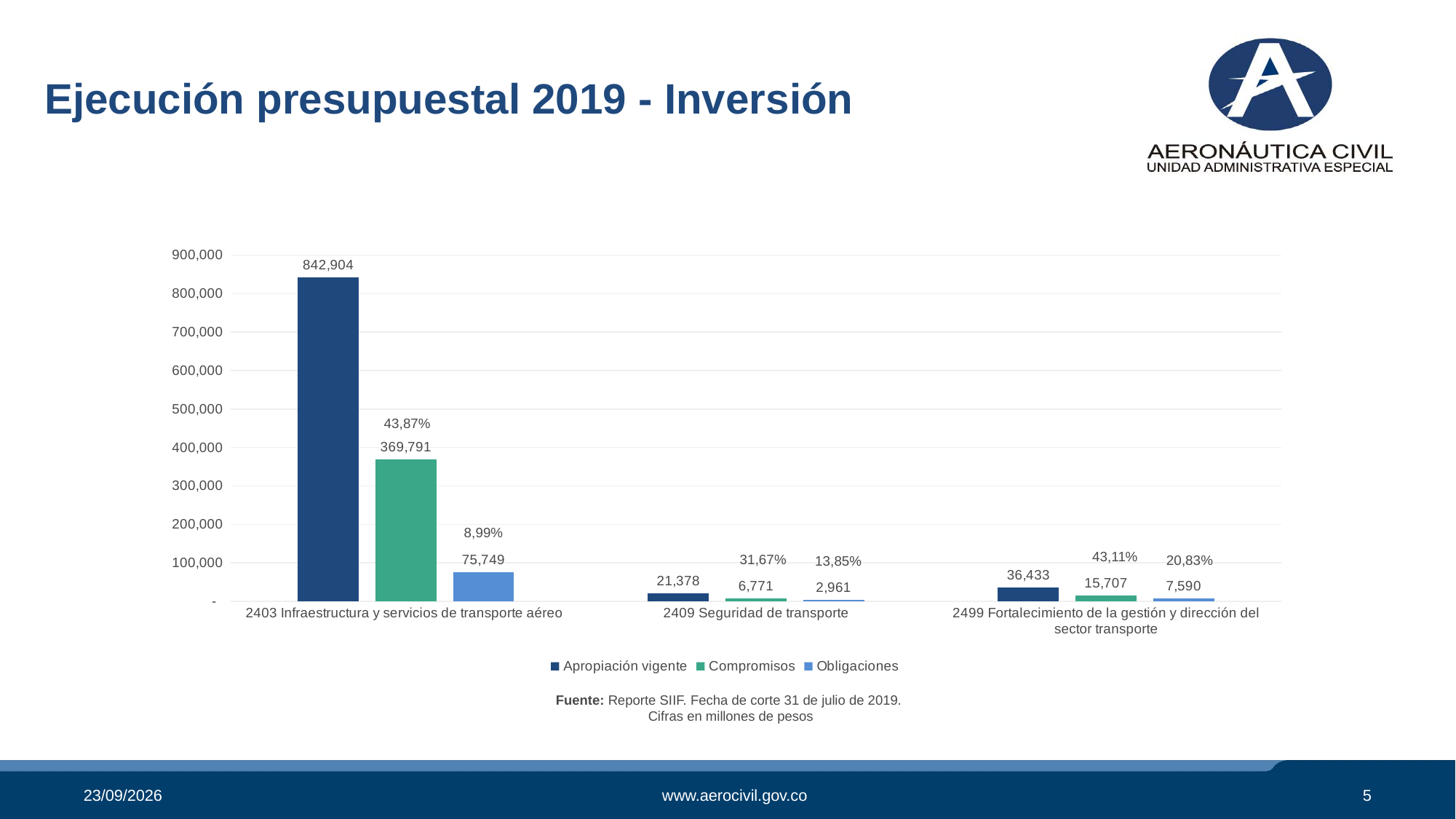
What is the Obligaciones value for 2499 Fortalecimiento de la gestión y dirección del sector transporte? 7,590 Which category has the lowest Obligaciones value? 2409 Seguridad de transporte What is the Apropiación vigente value for 2403 Infraestructura y servicios de transporte aéreo? 842,904 What is the difference between Apropiación vigente and Compromisos for 2403 Infraestructura y servicios de transporte aéreo? 473,113 What is the difference between the Apropiación vigente values for 2499 Fortalecimiento de la gestión y dirección del sector transporte and 2409 Seguridad de transporte? 15,055 What kind of chart is shown on the slide? Bar chart How many categories are shown on the x axis? 3 Which is larger: Compromisos for 2499 Fortalecimiento de la gestión y dirección del sector transporte or Apropiación vigente for 2409 Seguridad de transporte? Apropiación vigente for 2409 Seguridad de transporte What percentage is shown above the Compromisos bar for 2403 Infraestructura y servicios de transporte aéreo? 43,87% What is the Compromisos value for 2409 Seguridad de transporte? 6,771 Which category has the highest Apropiación vigente value? 2403 Infraestructura y servicios de transporte aéreo How many series does the legend list? 3